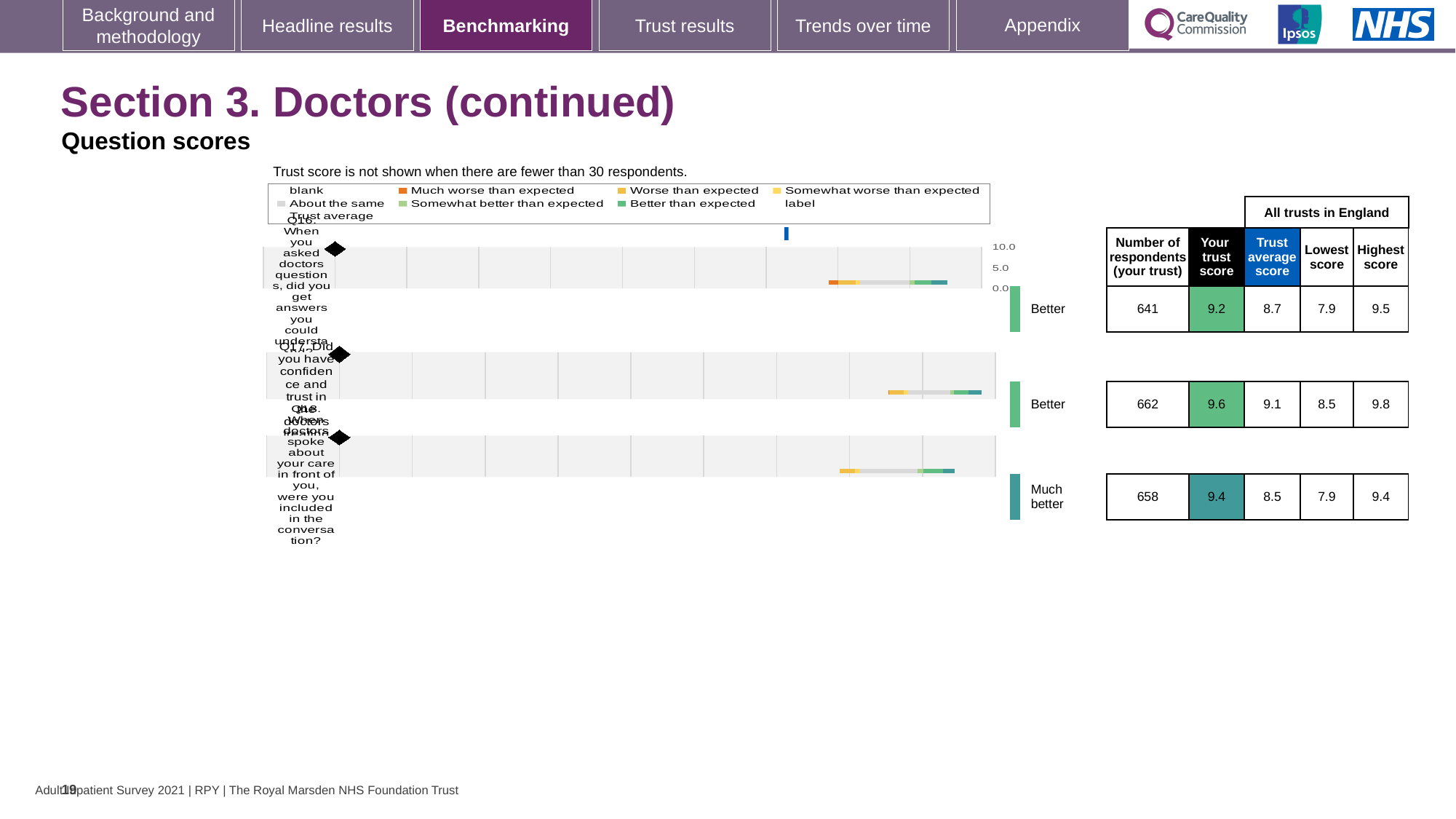
What benchmark category is shown next to the Q18 chart? Much better Which question has the highest 'Your trust score'? Q17 What is the highest value shown on the axis of the benchmarking charts? 10.0 How many questions (Q16, Q17, Q18) have benchmarking charts on this slide? 3 What is the trust average score for Q18 (doctors speaking about your care in front of you)? 8.5 How many respondents answered Q18 for this trust? 658 For Q16, which is larger: 'Your trust score' or the trust average score? Your trust score What kind of chart is used to show the Q16 benchmarking result? bar chart Which question has the lowest 'Your trust score'? Q16 For Q17, what is the difference between 'Your trust score' and the trust average score? 0.5 What is the highest score among all trusts in England for Q17? 9.8 What is the 'Your trust score' for Q17 (confidence and trust in the doctors)? 9.6